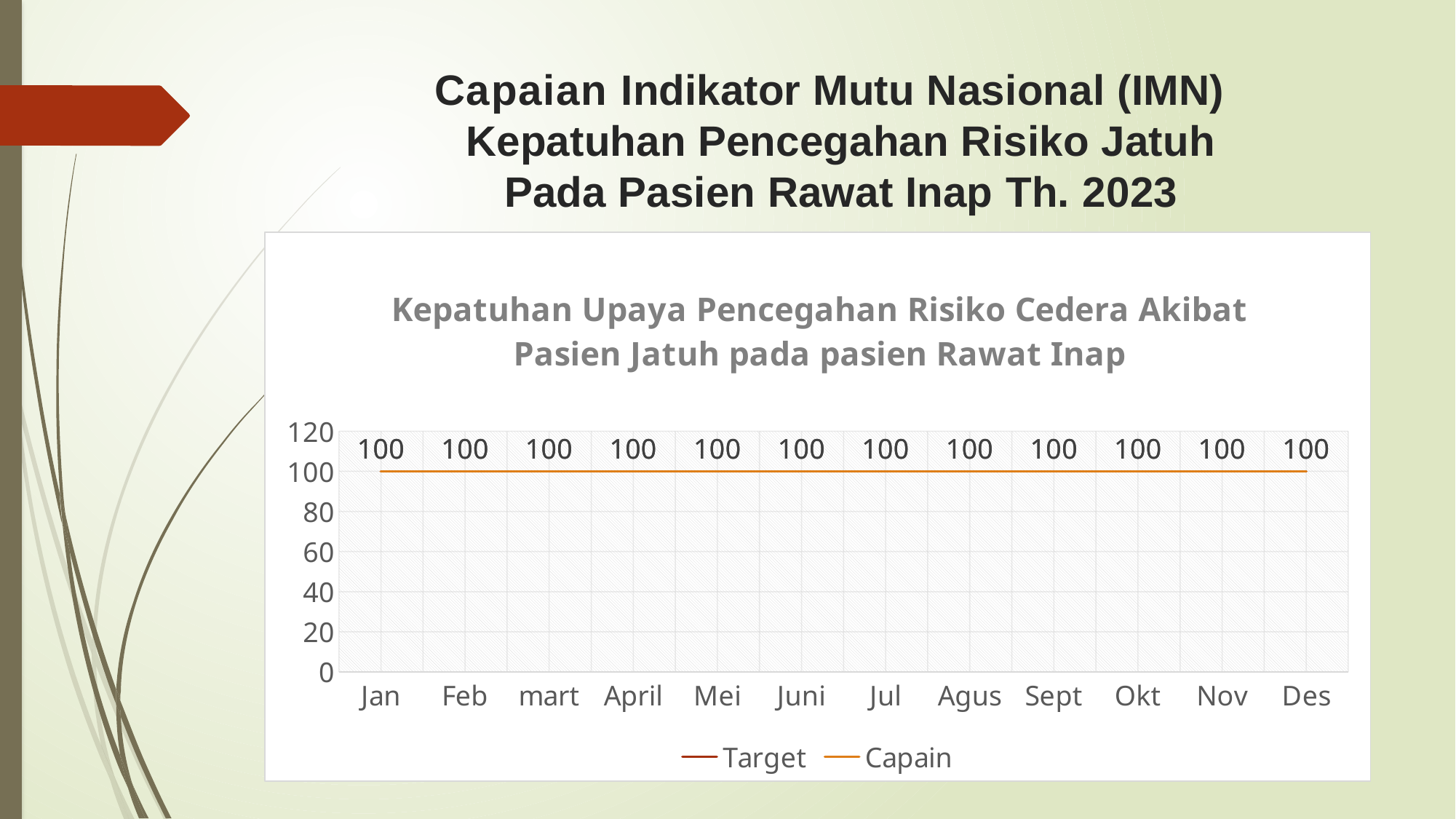
What is the difference between the value for Mei and the value for Okt? 0 What is the value shown for Jan in the chart? 100 How many months are shown on the x axis of the chart? 12 What is the value shown for Des in the chart? 100 What is the highest value shown on the vertical axis of the chart? 120 What are the two series names listed in the chart legend? Target and Capain How many series does the chart legend list? 2 Is the value for Feb greater or less than 120? less Is the value for Agus greater or less than 80? greater What is the value shown for Juni in the chart? 100 What kind of chart is shown on the slide? line chart Do the values rise, fall, or stay flat from Jan to Des? stay flat